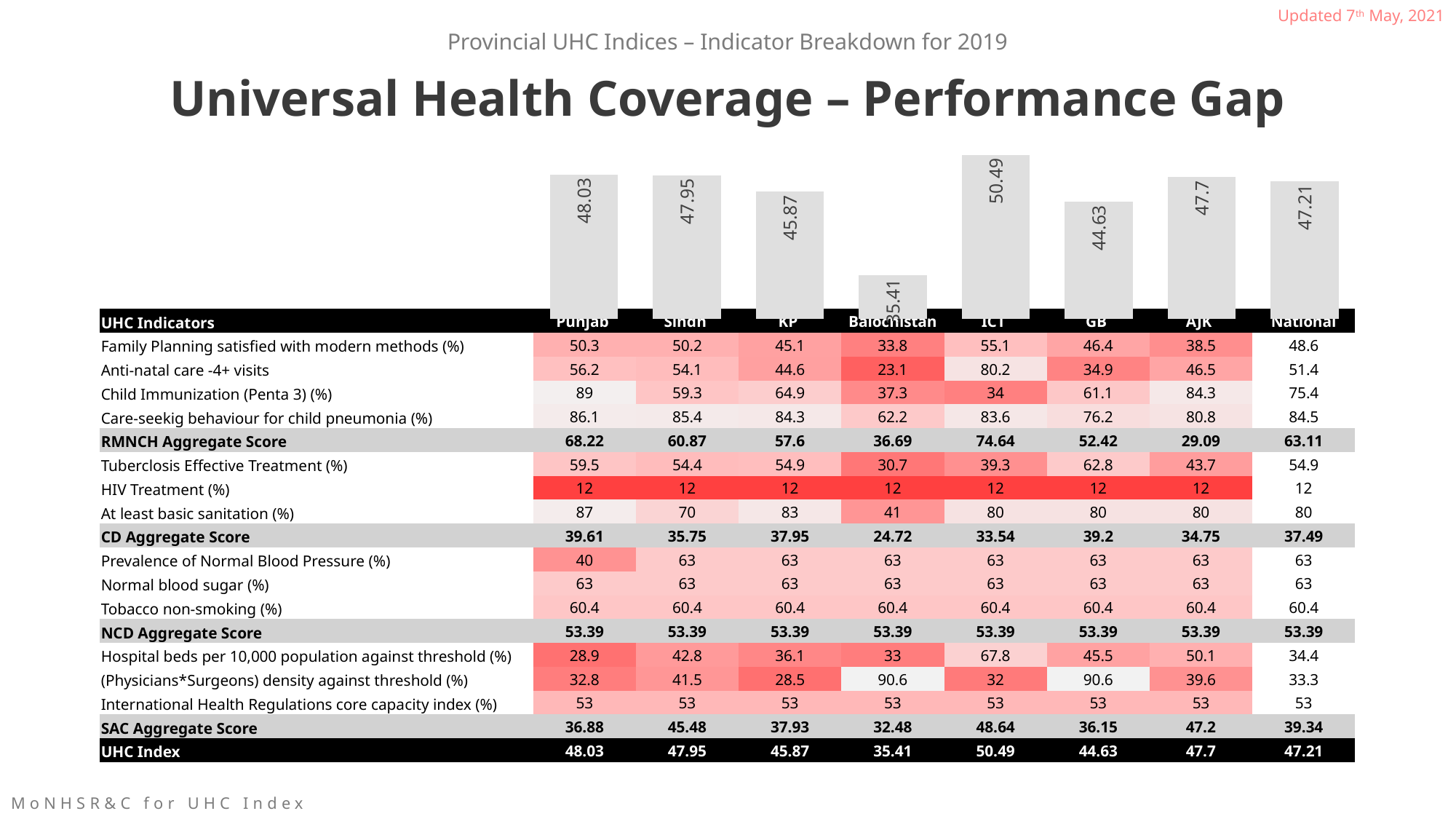
What is the value of the bar for GB in the bar chart? 44.63 What is the difference between the bar values for Punjab and KP in the bar chart? 2.16 What is the value of the bar for ICT in the bar chart? 50.49 Which category has the highest bar in the bar chart? ICT In the bar chart, which is larger: the bar for Sindh or the bar for Balochistan? Sindh What is the value of the bar for National in the bar chart? 47.21 Which category has the lowest bar in the bar chart? Balochistan In the bar chart, which is larger: the bar for KP or the bar for GB? KP How many bars are shown in the bar chart? 8 What is the difference between the bar values for ICT and Balochistan in the bar chart? 15.08 What is the value of the bar for Balochistan in the bar chart? 35.41 What kind of chart is shown above the table? Bar chart